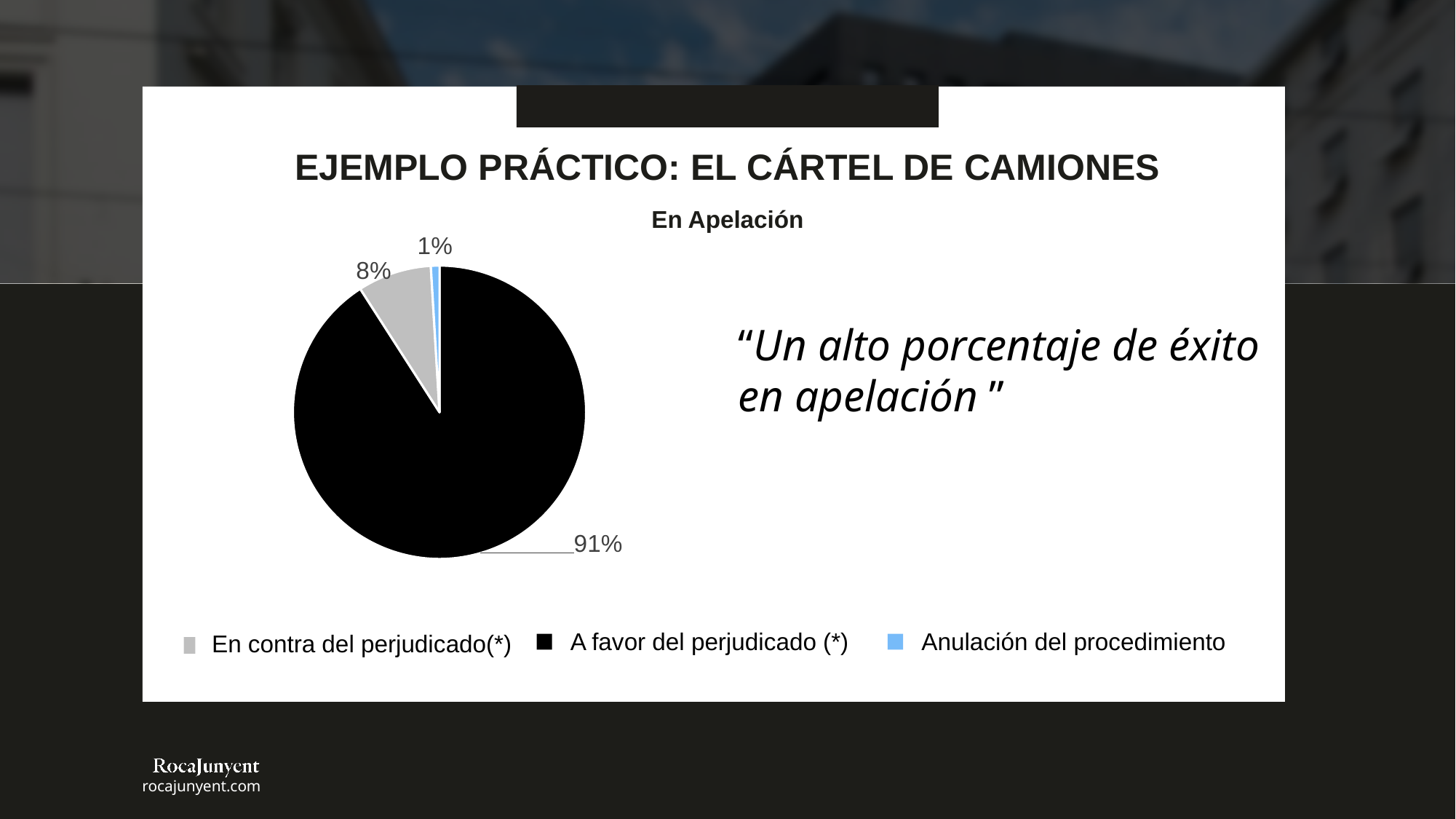
Which category has the largest slice of the pie? A favor del perjudicado (*) What is the chart's title? En Apelación What share of the pie is 'En contra del perjudicado(*)'? 8% Which is larger, the share for 'En contra del perjudicado(*)' or for 'Anulación del procedimiento'? En contra del perjudicado(*) What colour is the slice for 'Anulación del procedimiento'? light blue What share of the pie is 'Anulación del procedimiento'? 1% What is the difference between the 'A favor del perjudicado (*)' share and the 'En contra del perjudicado(*)' share? 83% How many categories does the pie chart have? 3 Which category has the smallest slice of the pie? Anulación del procedimiento What share of the pie is 'A favor del perjudicado (*)'? 91% What kind of chart is shown on the slide? pie chart What is the difference between the 'En contra del perjudicado(*)' share and the 'Anulación del procedimiento' share? 7%